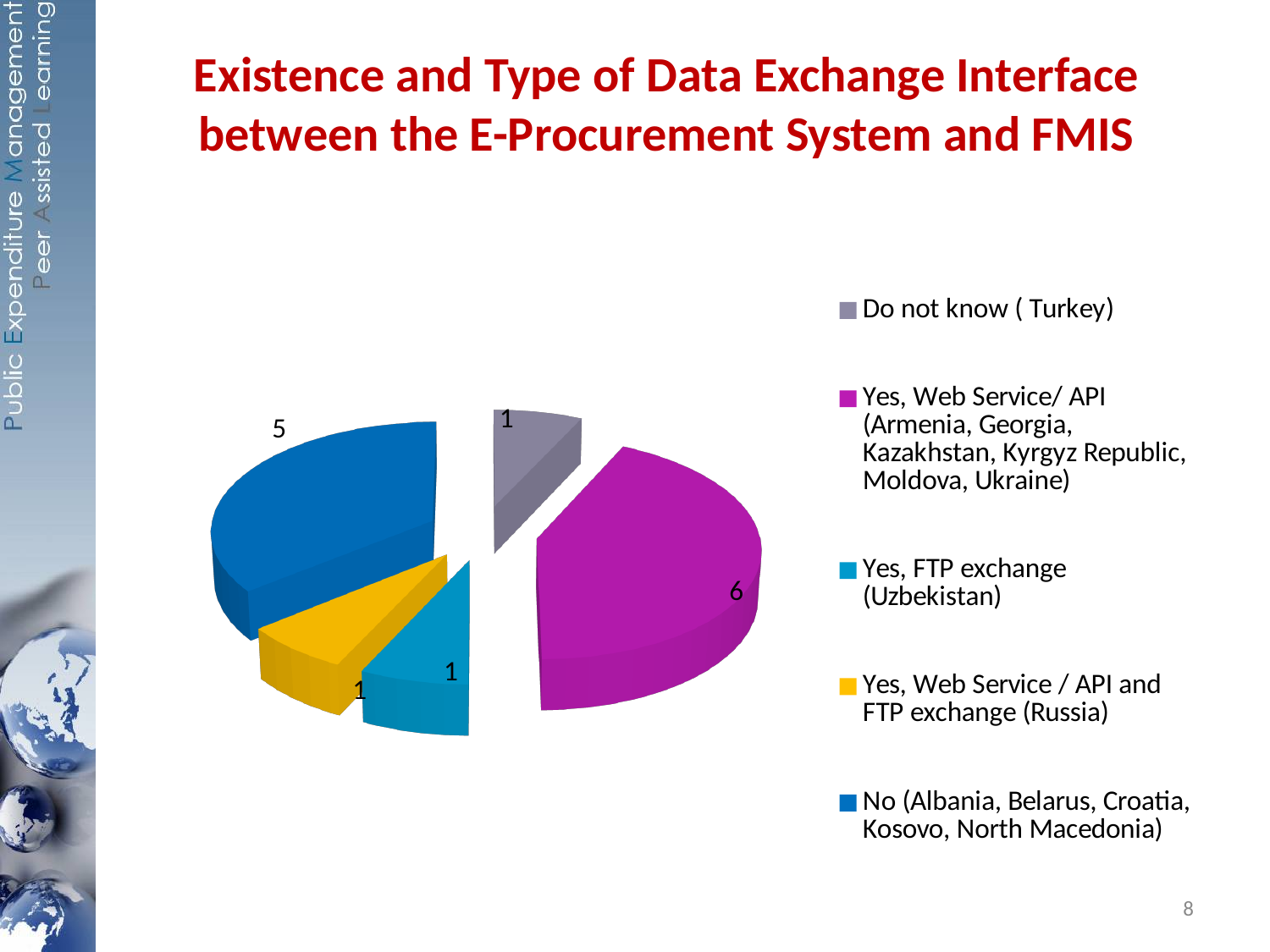
What is the value for the 'Yes, Web Service/ API' slice? 6 What is the total of all the slice values in the pie chart? 14 What is the difference between the 'Yes, Web Service/ API' slice and the 'No' slice? 1 Which is larger, the 'No' slice or the 'Yes, Web Service / API and FTP exchange (Russia)' slice? No What colour is the 'Yes, Web Service/ API' slice? Magenta What kind of chart is shown on the slide? Pie chart How many entries does the legend list? 5 Which category has the largest slice of the pie? Yes, Web Service/ API How many slices does the pie chart have? 5 What is the value for the 'Do not know ( Turkey)' slice? 1 What is the value for the 'Yes, FTP exchange (Uzbekistan)' slice? 1 What is the value for the 'No' slice (Albania, Belarus, Croatia, Kosovo, North Macedonia)? 5